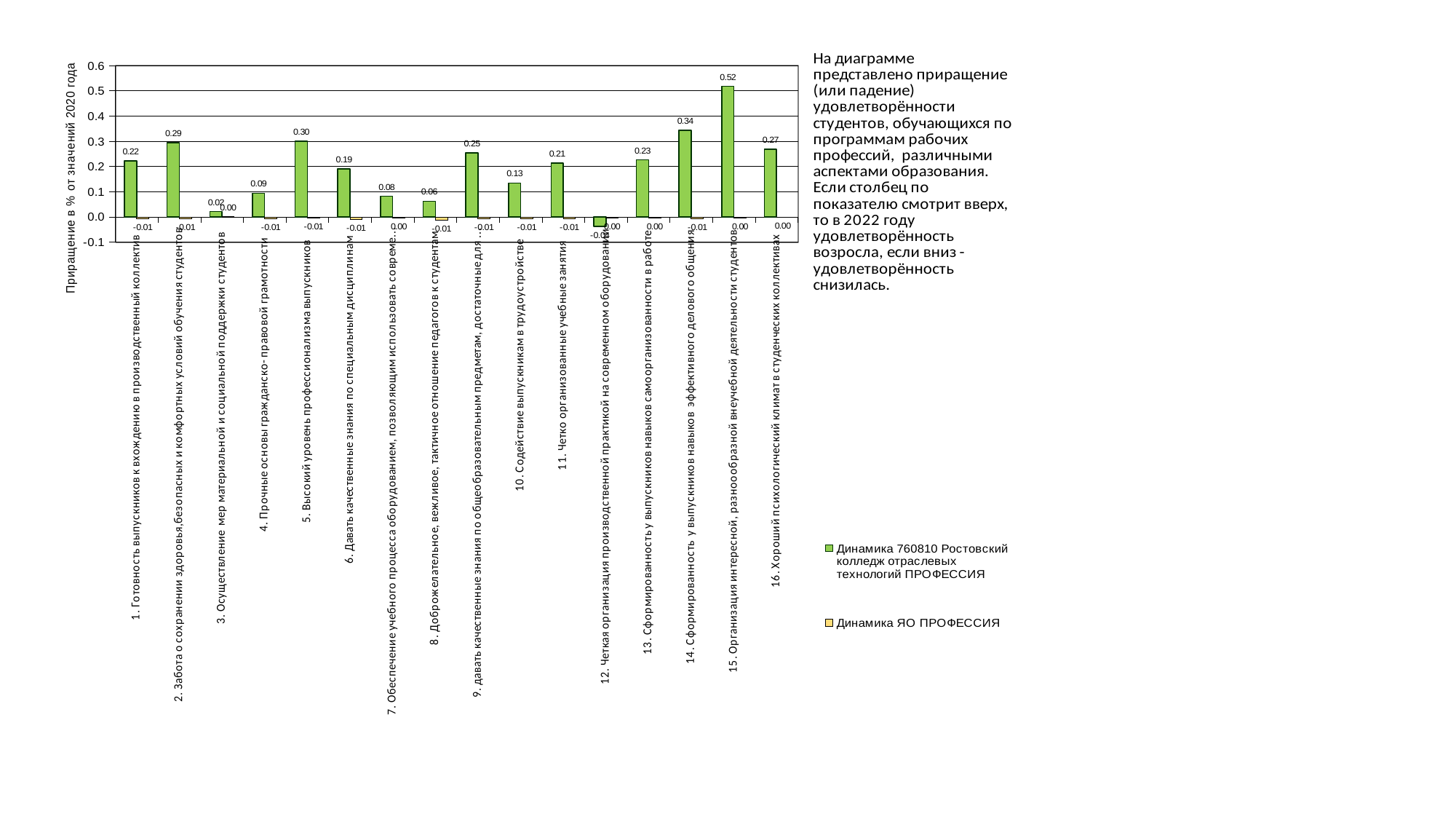
How many categories are shown on the x axis? 16 What is the value of the 'Динамика 760810 Ростовский колледж отраслевых технологий ПРОФЕССИЯ' series for category 15 (Организация интересной, разнообразной внеучебной деятельности студентов)? 0.52 What is the value of the 'Динамика 760810 Ростовский колледж отраслевых технологий ПРОФЕССИЯ' series for category 5 (Высокий уровень профессионализма выпускников)? 0.30 Which category has the highest value for the 'Динамика 760810 Ростовский колледж отраслевых технологий ПРОФЕССИЯ' series? 15. Организация интересной, разнообразной внеучебной деятельности студентов Is the 'Динамика 760810 Ростовский колледж отраслевых технологий ПРОФЕССИЯ' value for category 14 greater or less than 0.3? greater How many series does the legend list? 2 What type of chart is shown on the slide? bar chart For the 'Динамика 760810 Ростовский колледж отраслевых технологий ПРОФЕССИЯ' series, which is larger: category 2 (Забота о сохранении здоровья) or category 6 (Давать качественные знания по специальным дисциплинам)? category 2 (0.29) What is the value of the 'Динамика 760810 Ростовский колледж отраслевых технологий ПРОФЕССИЯ' series for category 3 (Осуществление мер материальной и социальной поддержки студентов)? 0.02 What is the difference between the 'Динамика 760810 Ростовский колледж отраслевых технологий ПРОФЕССИЯ' values for category 15 and category 14? 0.18 What is the label of the y axis? Приращение в % от значений 2020 года What is the value of the 'Динамика ЯО ПРОФЕССИЯ' series for category 1 (Готовность выпускников к вхождению в производственный коллектив)? -0.01